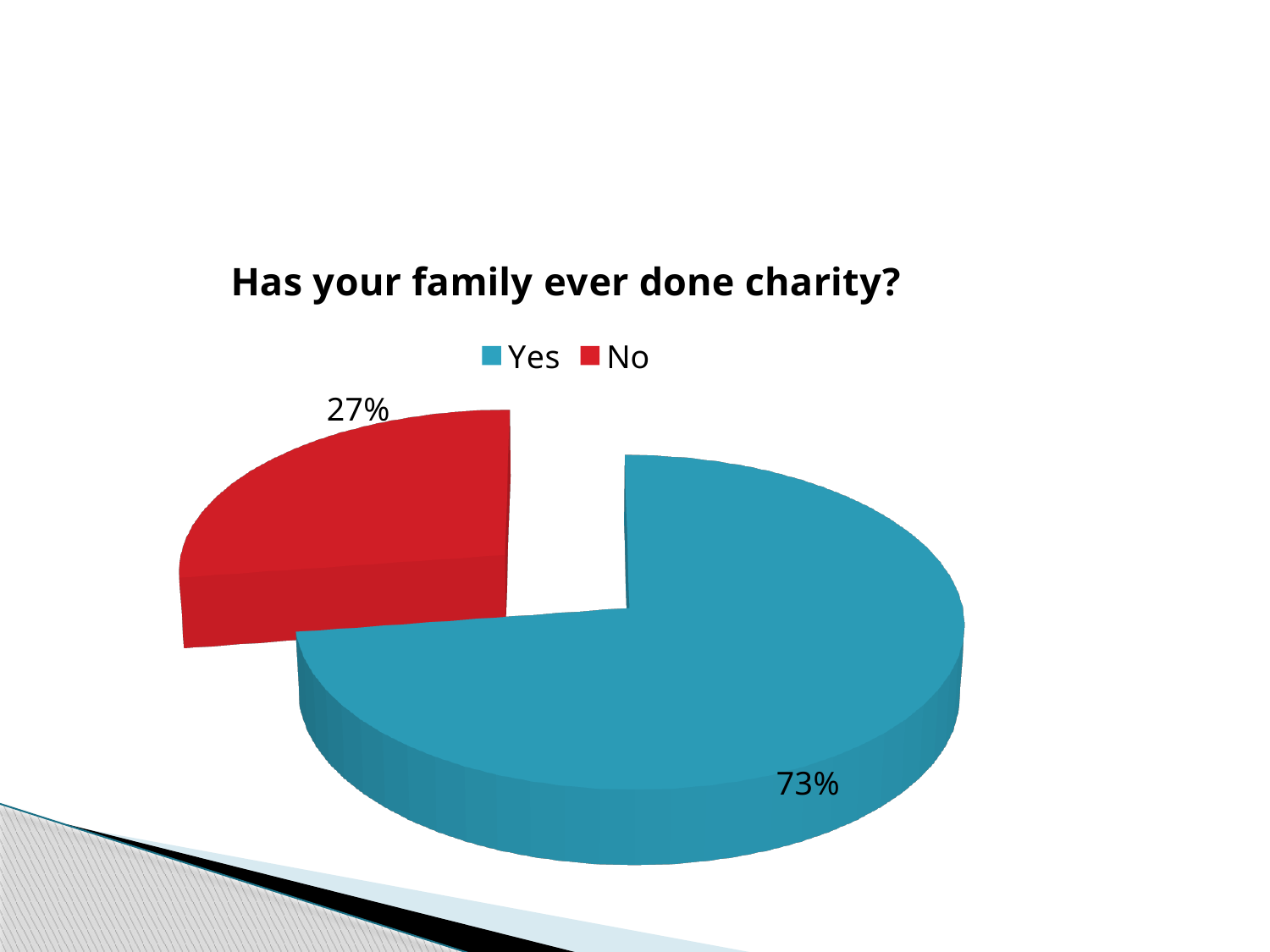
Which is larger, the share for Yes or the share for No? Yes How many entries does the legend list? 2 Which response has the smallest share of the pie? No What colour is the slice for No? Red What is the title of the chart? Has your family ever done charity? What percentage of respondents answered Yes? 73% What kind of chart is shown on the slide? Pie chart Which response has the largest share of the pie? Yes What is the difference in percentage points between the Yes and No shares? 46 Is the share for Yes greater or less than 50%? greater What percentage of respondents answered No? 27% How many slices does the pie chart have? 2